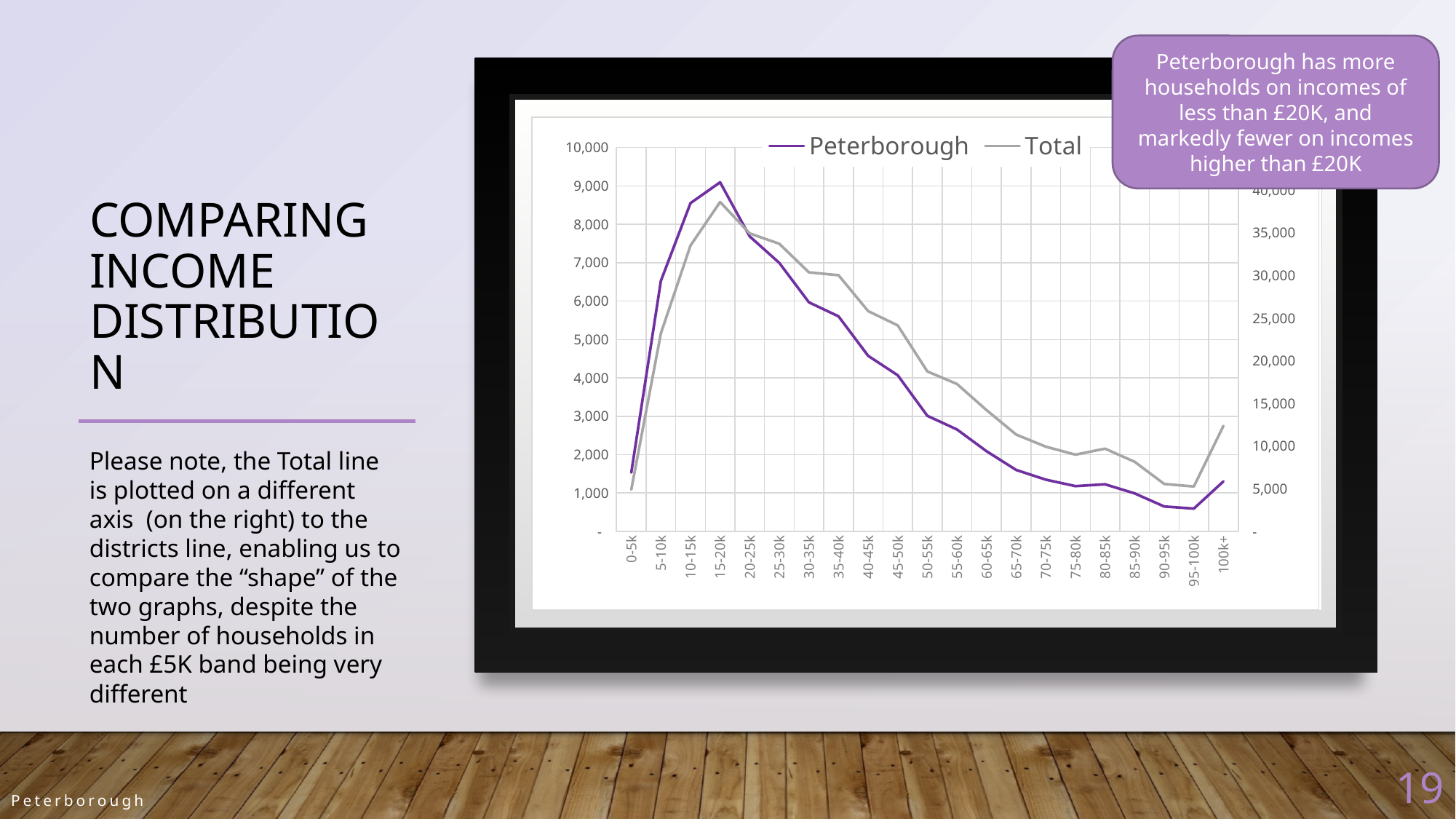
How many income bands are shown along the x axis of the chart? 21 Is the Total value for the 100k+ band, read on the right-hand axis, greater or less than 10,000? greater Does the Peterborough line rise or fall between the 15-20k band and the 95-100k band? fall Is the Peterborough value for the 0-5k band greater or less than 2,000? less In which income band does the Peterborough line reach its highest value? 15-20k Is the Peterborough value for the 15-20k band greater or less than 8,000? greater What kind of chart is shown on the slide? line chart Which band has the higher Peterborough value, 5-10k or 10-15k? 10-15k Which series in the chart is plotted against the right-hand axis? Total How many series does the chart legend list? 2 In which income band does the Peterborough line reach its lowest value? 95-100k